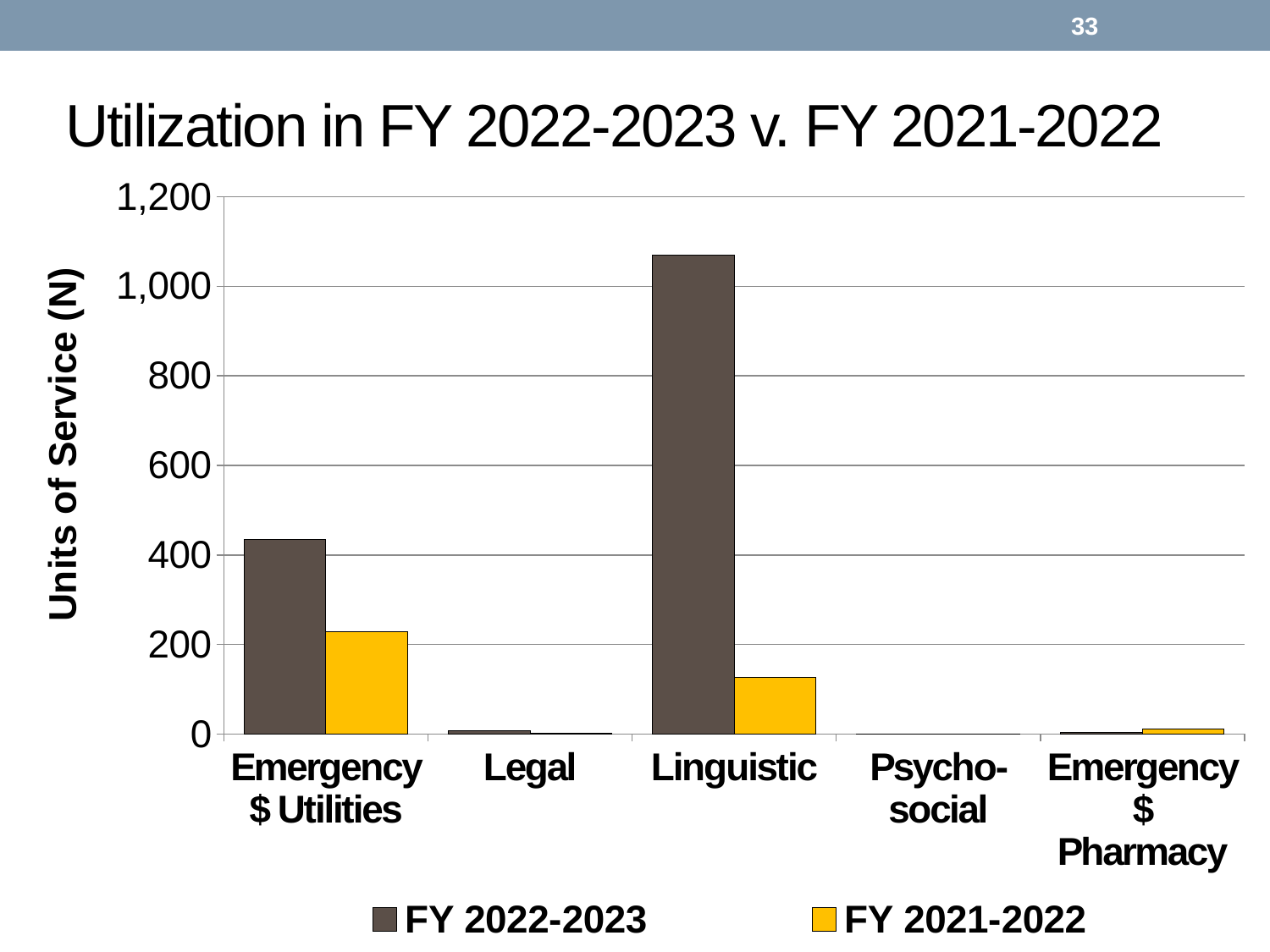
For Emergency $ Pharmacy, which series has the larger value, FY 2022-2023 or FY 2021-2022? FY 2021-2022 For Linguistic, which series has the larger value, FY 2022-2023 or FY 2021-2022? FY 2022-2023 Is the FY 2021-2022 value for Emergency $ Utilities greater or less than 200? greater What is the title of the y axis? Units of Service (N) Which category has the highest FY 2022-2023 value? Linguistic What kind of chart is shown on the slide? bar chart Which category has the highest FY 2021-2022 value? Emergency $ Utilities How many service categories are shown on the x axis? 5 Is the FY 2022-2023 value for Emergency $ Utilities greater or less than 400? greater Is the FY 2021-2022 value for Linguistic greater or less than 200? less How many series does the legend list? 2